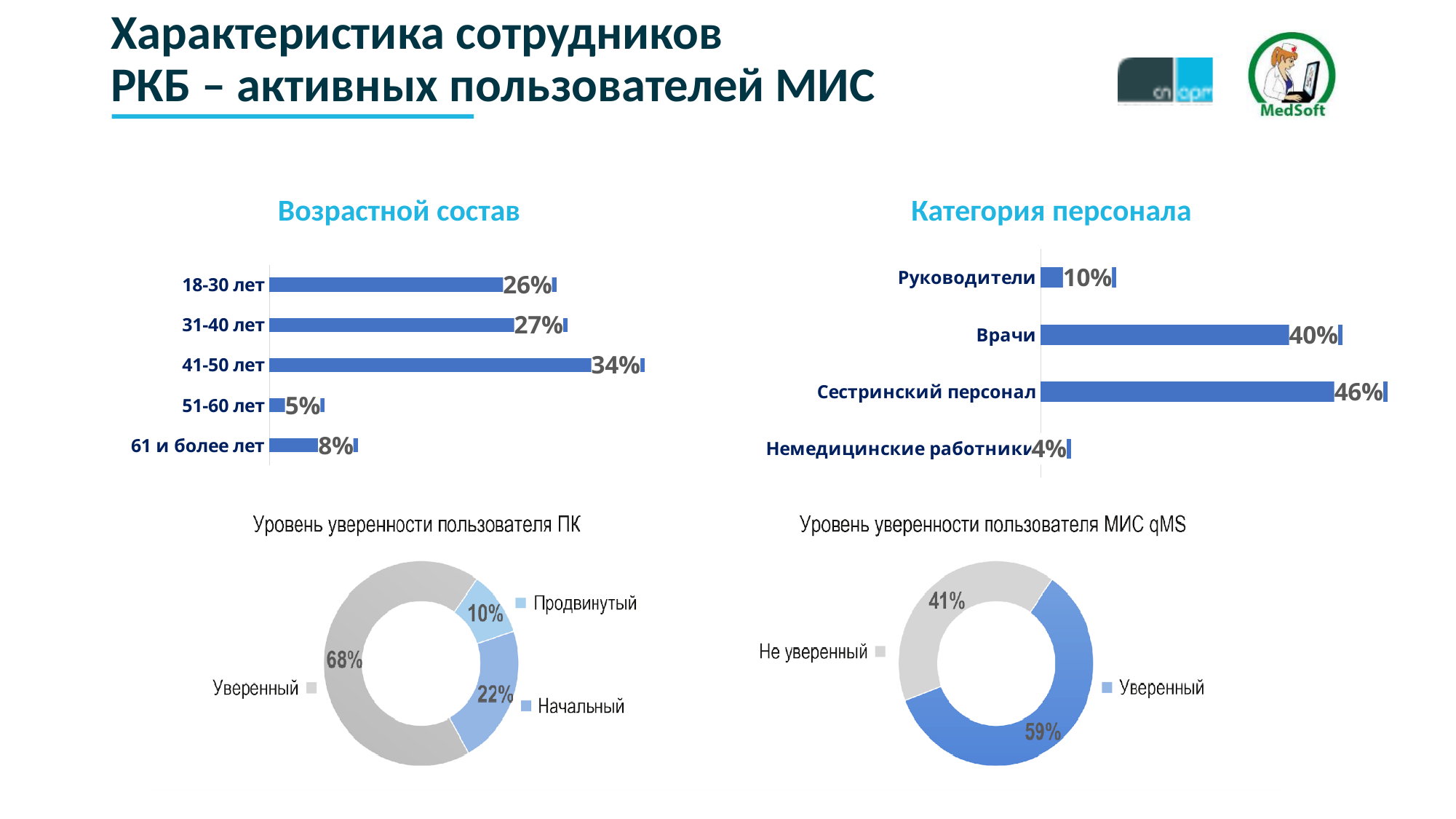
In the 'Категория персонала' chart, which category has the highest value? Сестринский персонал In the 'Категория персонала' chart, what is the value for Врачи? 40% In the 'Уровень уверенности пользователя МИС qMS' chart, what share is Не уверенный? 41% In the 'Возрастной состав' chart, what is the value for 41-50 лет? 34% What kind of chart is the 'Категория персонала' chart? Bar chart In the 'Уровень уверенности пользователя ПК' chart, what is the difference between Начальный and Продвинутый? 12% In the 'Уровень уверенности пользователя ПК' chart, what share is Уверенный? 68% In the 'Возрастной состав' chart, which age group has the lowest value? 51-60 лет In the 'Категория персонала' chart, which is larger: Руководители or Немедицинские работники? Руководители In the 'Возрастной состав' chart, what is the difference between the values for 41-50 лет and 18-30 лет? 8% In the 'Возрастной состав' chart, how many age categories are shown? 5 How many entries does the legend of the 'Уровень уверенности пользователя ПК' chart list? 3